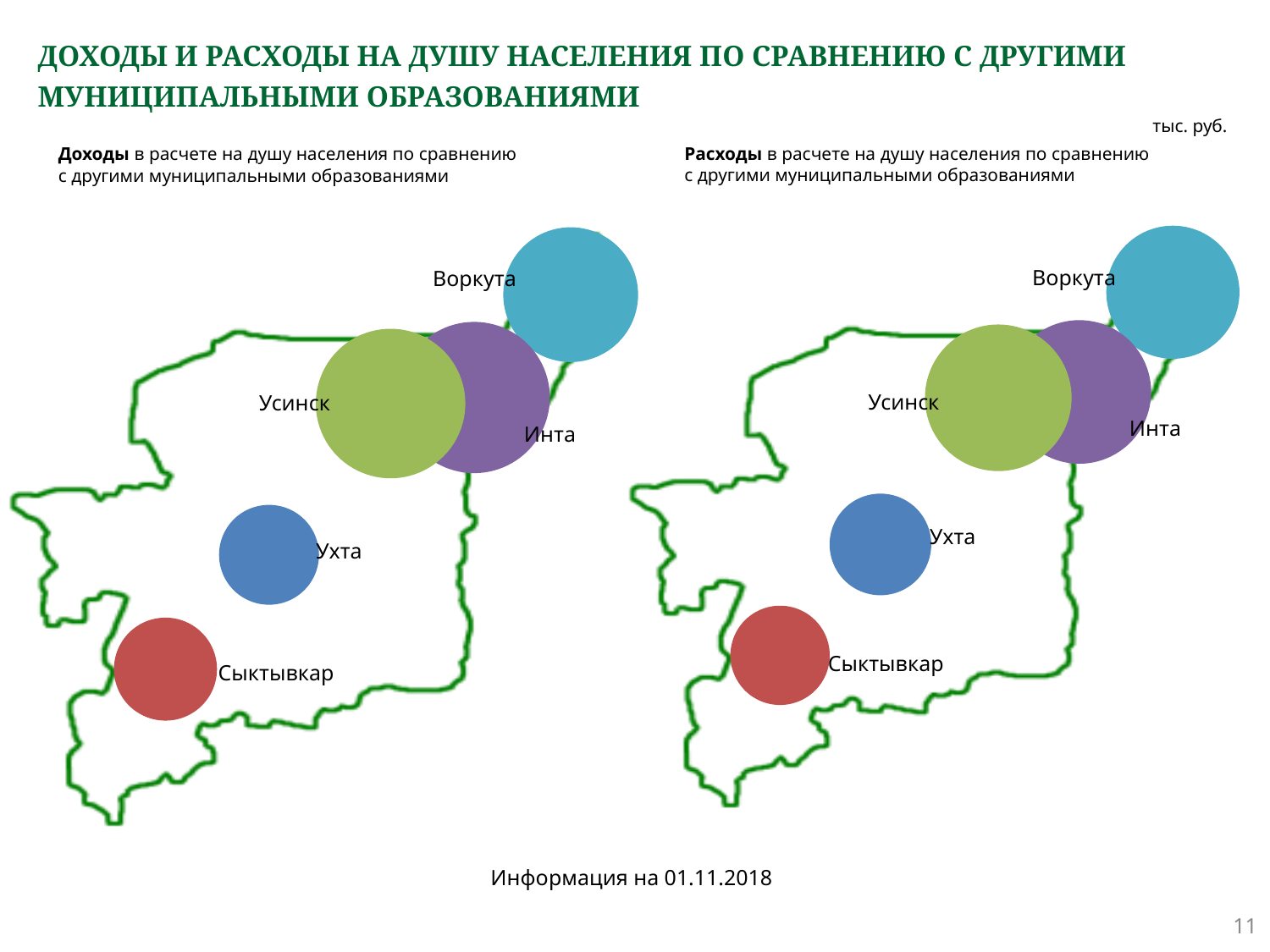
How many municipalities (bubbles) are shown on the right (Расходы) chart? 5 What kind of chart is used on the left (Доходы) chart? Bubble chart What unit of measurement is indicated for the charts on the slide? тыс. руб. On the left (Доходы) chart, which bubble is larger: Воркута or Сыктывкар? Воркута On the right (Расходы) chart, which bubble is larger: Усинск or Сыктывкар? Усинск On the right (Расходы) chart, which bubble is larger: Воркута or Ухта? Воркута How many municipalities (bubbles) are shown on the left (Доходы) chart? 5 What colour is the Сыктывкар bubble on the left (Доходы) chart? Red